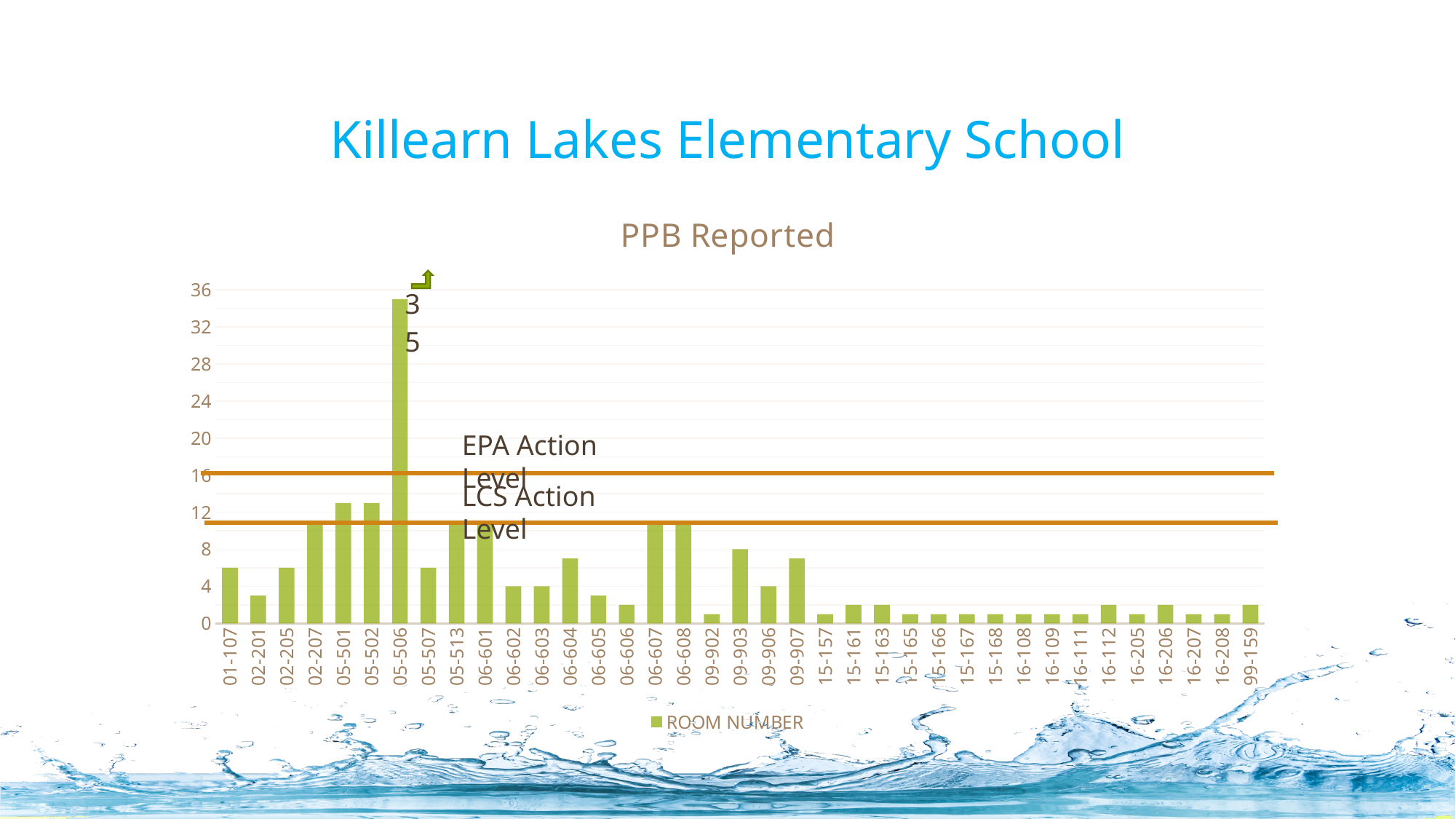
Which has a larger value, room 02-201 or room 02-205? 02-205 What is the PPB reported value for room 05-506? 35 Which room number has the highest PPB reported value? 05-506 Is the value for room 05-501 greater or less than 12? greater What type of chart is shown on the slide? bar chart How many series does the chart legend list? 1 What is the title of the chart? PPB Reported What is the name of the series shown in the legend? ROOM NUMBER Is the value for room 15-157 greater or less than 4? less Which has a larger value, room 09-903 or room 09-906? 09-903 How many room numbers are shown on the x axis of the chart? 37 Is the value for room 02-207 greater or less than 8? greater